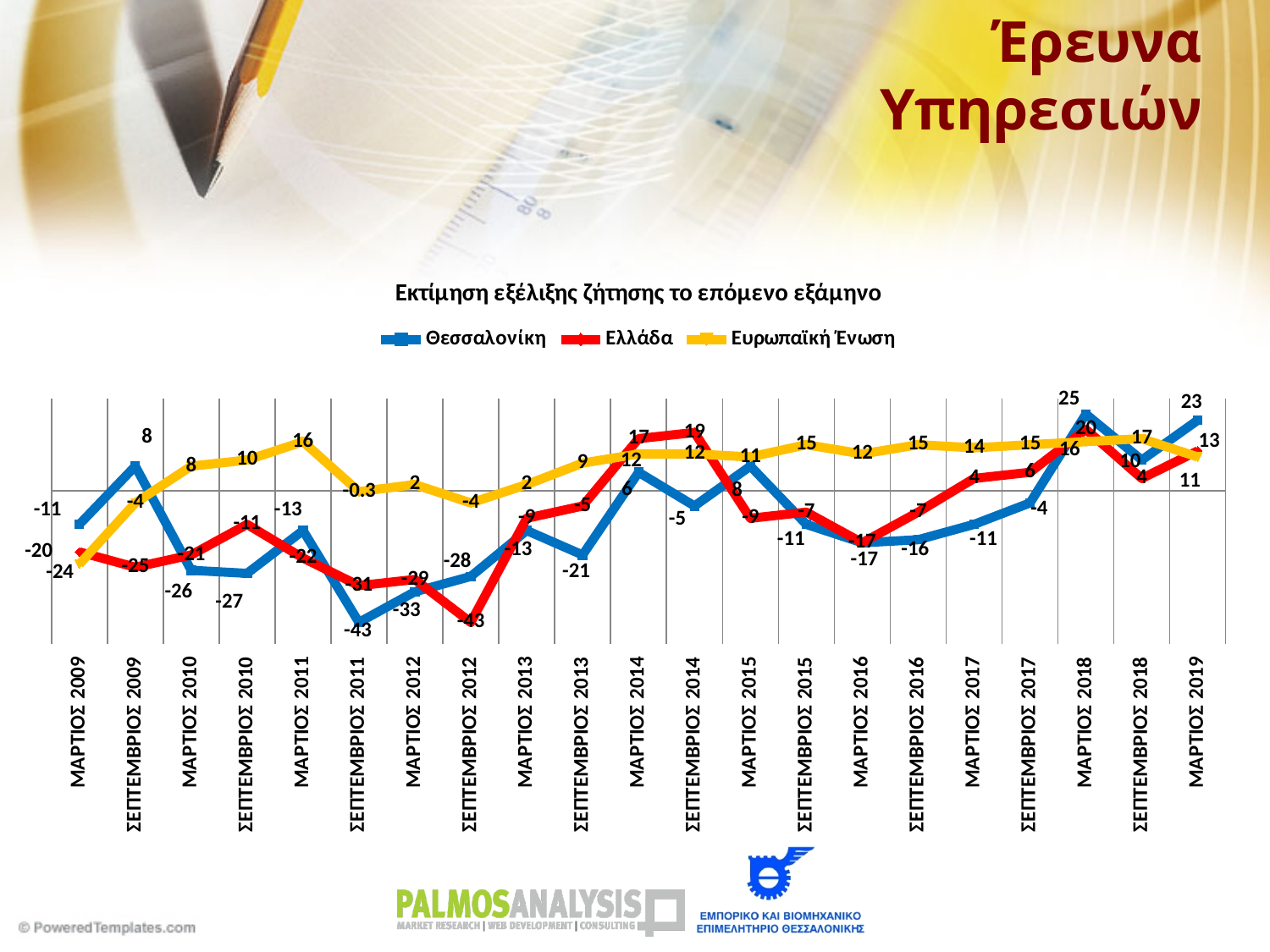
In which period does Θεσσαλονίκη reach its highest value? ΜΑΡΤΙΟΣ 2018 What is the title of the chart? Εκτίμηση εξέλιξης ζήτησης το επόμενο εξάμηνο What is the value for Ευρωπαϊκή Ένωση in ΜΑΡΤΙΟΣ 2011? 16 What is the value for Θεσσαλονίκη in ΣΕΠΤΕΜΒΡΙΟΣ 2011? -43 In which period does Ελλάδα reach its lowest value? ΣΕΠΤΕΜΒΡΙΟΣ 2012 How many time points are shown on the x axis? 21 What is the value for Θεσσαλονίκη in ΜΑΡΤΙΟΣ 2018? 25 What is the value for Ελλάδα in ΣΕΠΤΕΜΒΡΙΟΣ 2014? 19 How many series does the legend list? 3 In ΣΕΠΤΕΜΒΡΙΟΣ 2014, which is higher: Ελλάδα or Θεσσαλονίκη? Ελλάδα What is the difference between Θεσσαλονίκη and Ευρωπαϊκή Ένωση in ΜΑΡΤΙΟΣ 2019? 12 What kind of chart is shown on the slide? Line chart